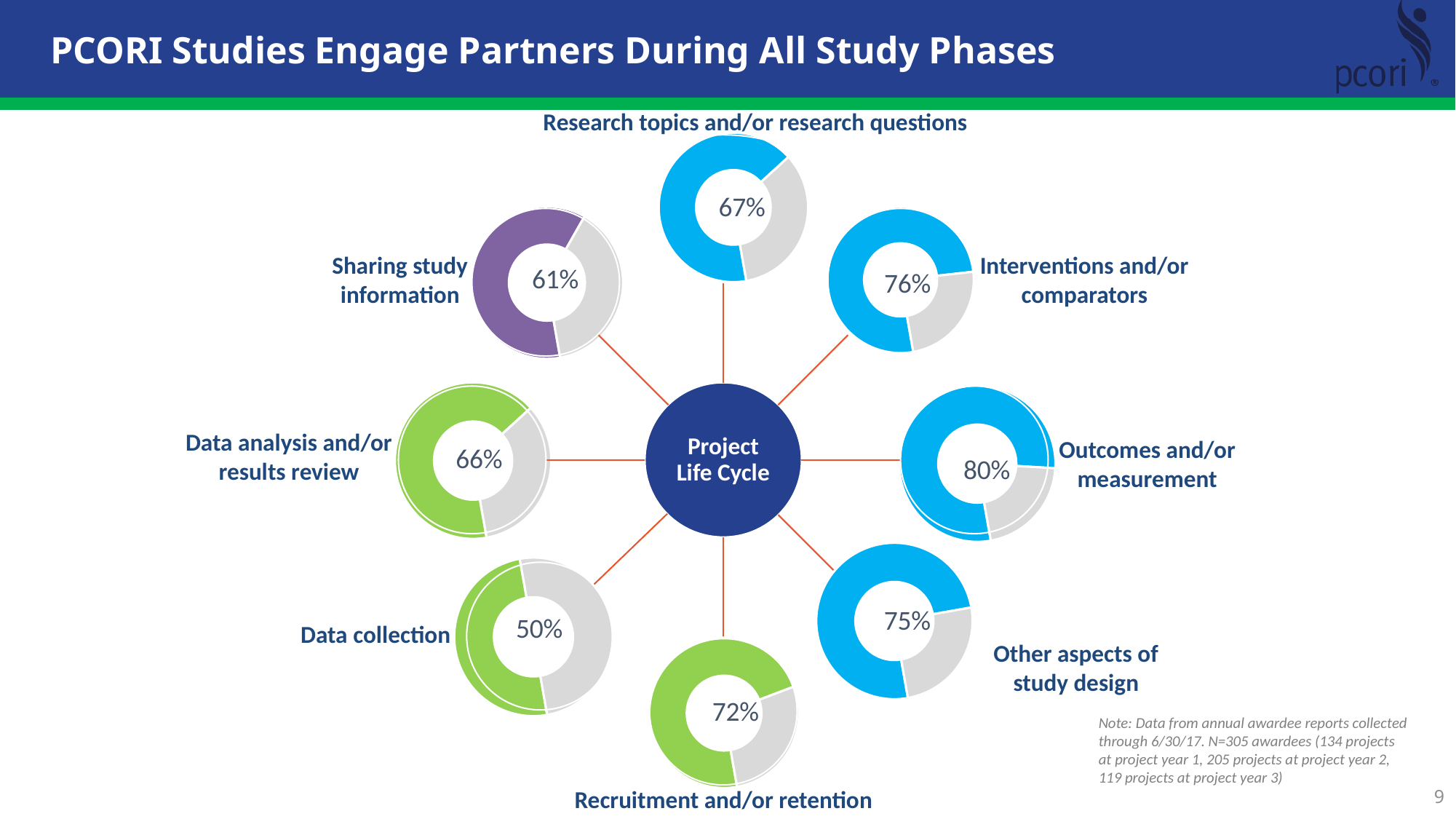
What percentage is shown in the donut chart labelled "Recruitment and/or retention"? 72% What percentage is shown in the donut chart labelled "Data collection"? 50% Which study phase's donut chart shows the lowest percentage? Data collection What percentage is shown in the donut chart labelled "Sharing study information"? 61% What kind of chart is used to show each percentage on the slide? Donut chart How many donut charts are arranged around the "Project Life Cycle" circle? 8 What is the difference between the percentages shown for "Interventions and/or comparators" and "Research topics and/or research questions"? 9% What text appears in the central circle that the donut charts surround? Project Life Cycle Which shows a larger percentage: the "Other aspects of study design" chart or the "Data analysis and/or results review" chart? Other aspects of study design What is the difference between the percentages shown for "Recruitment and/or retention" and "Data collection"? 22% What percentage is shown in the donut chart labelled "Outcomes and/or measurement"? 80% Which study phase's donut chart shows the highest percentage? Outcomes and/or measurement